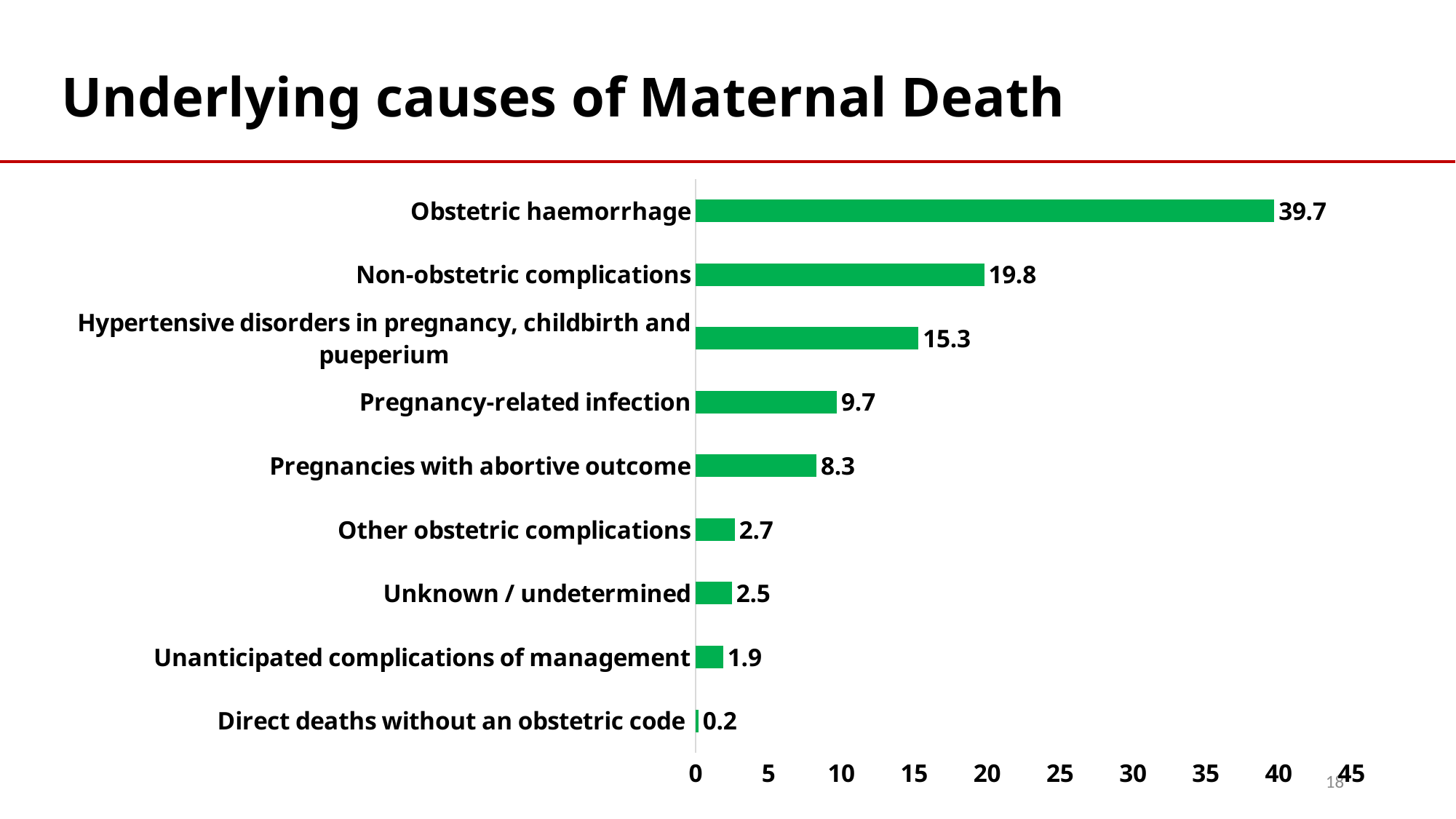
Which is larger, the value for Other obstetric complications or the value for Unanticipated complications of management? Other obstetric complications What is the value for Hypertensive disorders in pregnancy, childbirth and pueperium? 15.3 What is the value for Unknown / undetermined? 2.5 What is the difference between the values for Obstetric haemorrhage and Non-obstetric complications? 19.9 Which category has the lowest value? Direct deaths without an obstetric code Which category has the highest value? Obstetric haemorrhage What is the title of the slide? Underlying causes of Maternal Death Is the value for Non-obstetric complications greater or less than 15? greater How many categories are shown in the chart? 9 What is the difference between the values for Pregnancy-related infection and Pregnancies with abortive outcome? 1.4 What kind of chart is shown on the slide? bar chart What is the value for Obstetric haemorrhage? 39.7